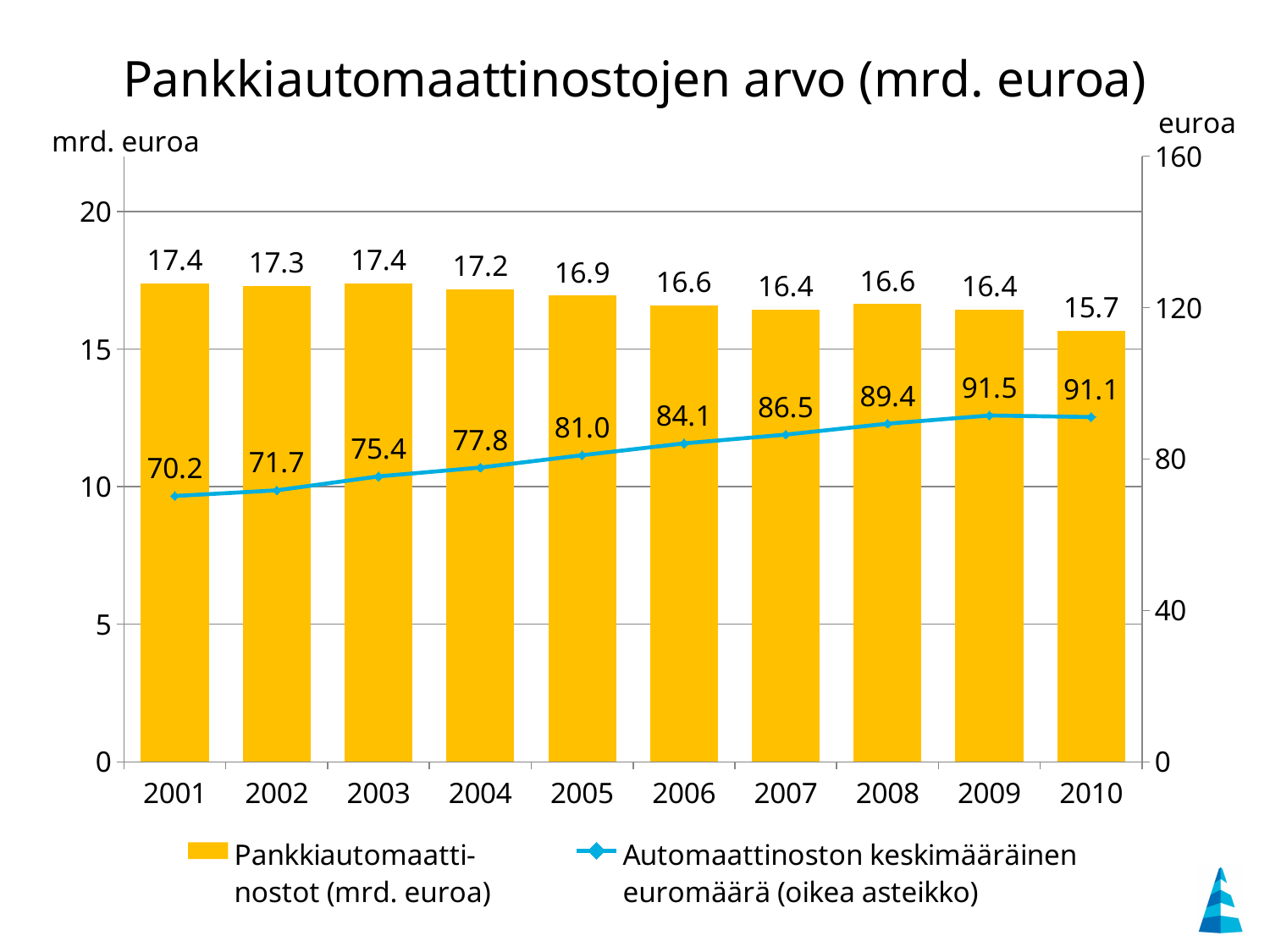
What is the value of Pankkiautomaattinostot (mrd. euroa) in 2010? 15.7 How many series does the legend list? 2 In which year is the value of Pankkiautomaattinostot (mrd. euroa) lowest? 2010 How many years are shown on the x axis? 10 Which year has a larger Pankkiautomaattinostot value, 2005 or 2008? 2005 What is the value of Pankkiautomaattinostot (mrd. euroa) in 2001? 17.4 What is the Automaattinoston keskimääräinen euromäärä in 2007? 86.5 Does the Automaattinoston keskimääräinen euromäärä line generally rise or fall from 2001 to 2009? Rise In which year is the Automaattinoston keskimääräinen euromäärä highest? 2009 What is the difference between the Pankkiautomaattinostot values in 2001 and 2010? 1.7 What is the difference between the Automaattinoston keskimääräinen euromäärä in 2009 and 2001? 21.3 What kind of chart is shown on the slide? Combined bar and line chart